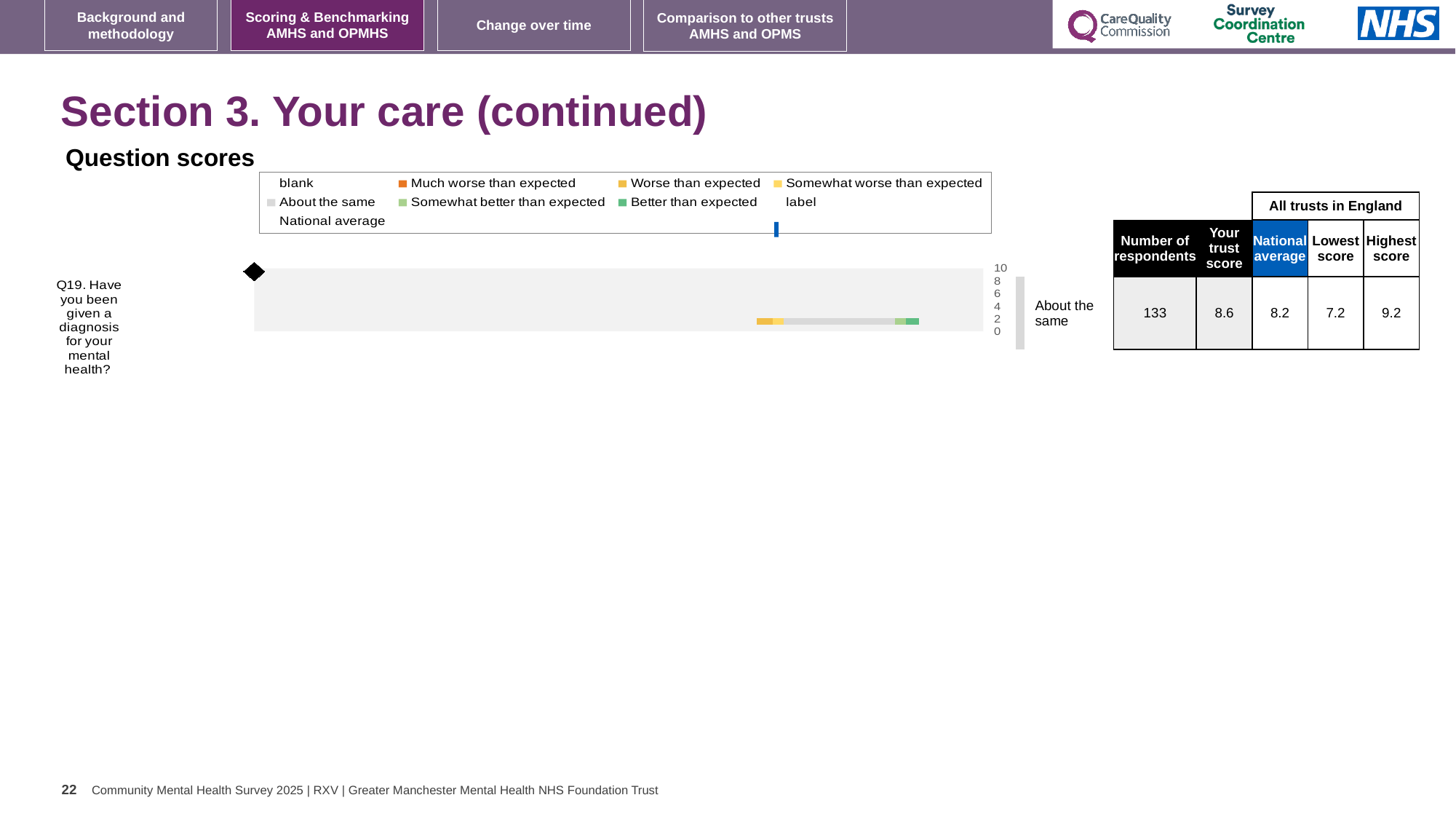
Which question is plotted in the Question scores chart? Q19. Have you been given a diagnosis for your mental health? What benchmark category is shown next to the bar for Q19? About the same What is the lowest score among all trusts in England for Q19? 7.2 How many respondents answered Q19? 133 What is the national average score for Q19? 8.2 What is the difference between the highest and lowest trust scores for Q19? 2.0 What is the highest score among all trusts in England for Q19? 9.2 What colour does the legend use for 'Much worse than expected'? orange What is the trust's score for Q19? 8.6 Is the trust's score for Q19 higher or lower than the national average? higher How many survey questions are plotted in the Question scores chart? 1 What kind of chart is used to show the Q19 question score? bar chart